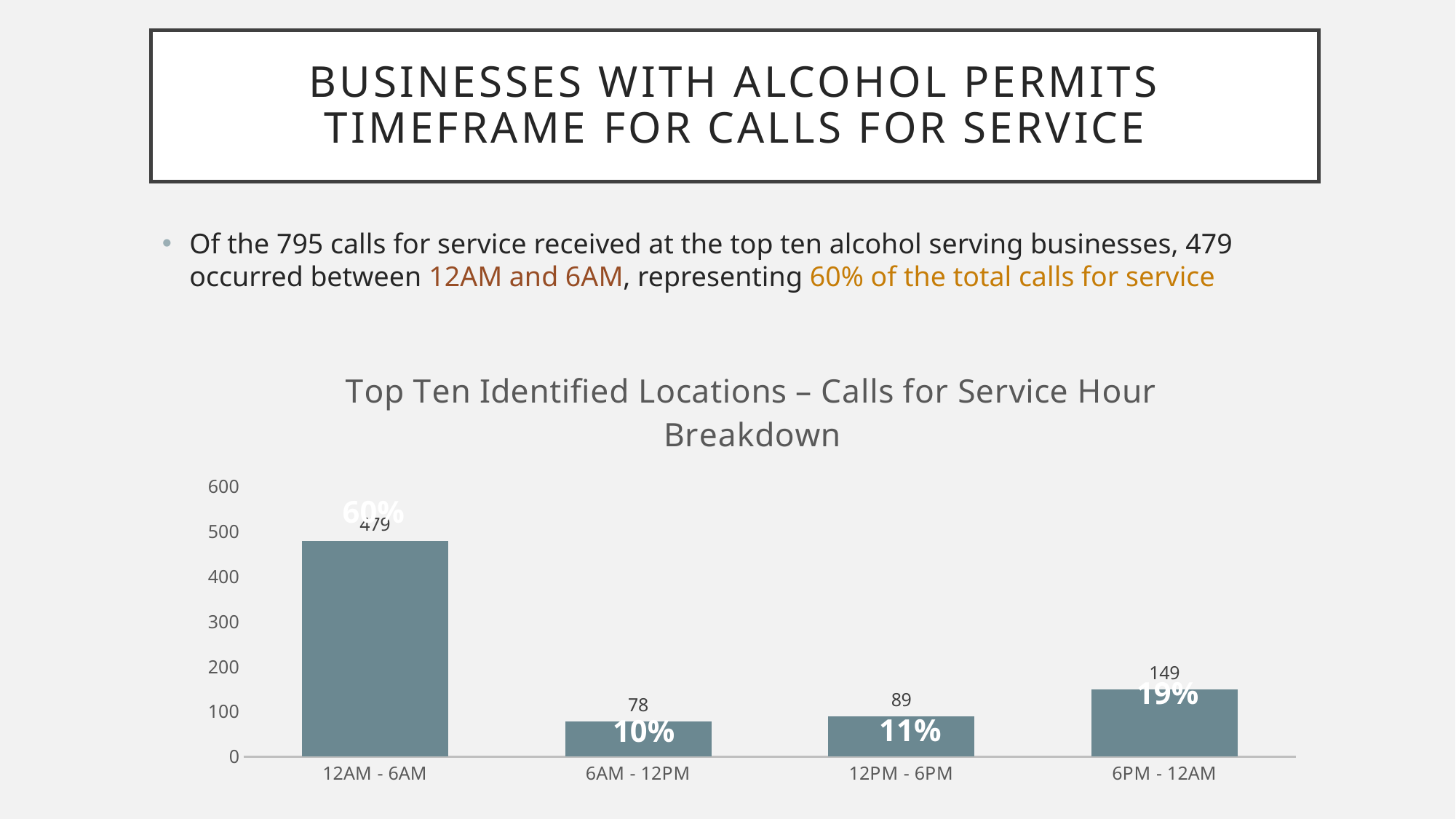
What is the value for 12PM - 6PM? 89 What is the value for 6PM - 12AM? 149 Which time period has the lowest number of calls for service? 6AM - 12PM What is the value for 6AM - 12PM? 78 What kind of chart is shown on the slide? bar chart What is the value for 12AM - 6AM? 479 Is the value for 6PM - 12AM greater or less than 100? greater What is the difference between the values for 12AM - 6AM and 6PM - 12AM? 330 Which is larger, the value for 12PM - 6PM or the value for 6PM - 12AM? 6PM - 12AM How many time periods are shown on the x axis? 4 What percentage label is shown on the 6PM - 12AM bar? 19% Which time period has the highest number of calls for service? 12AM - 6AM